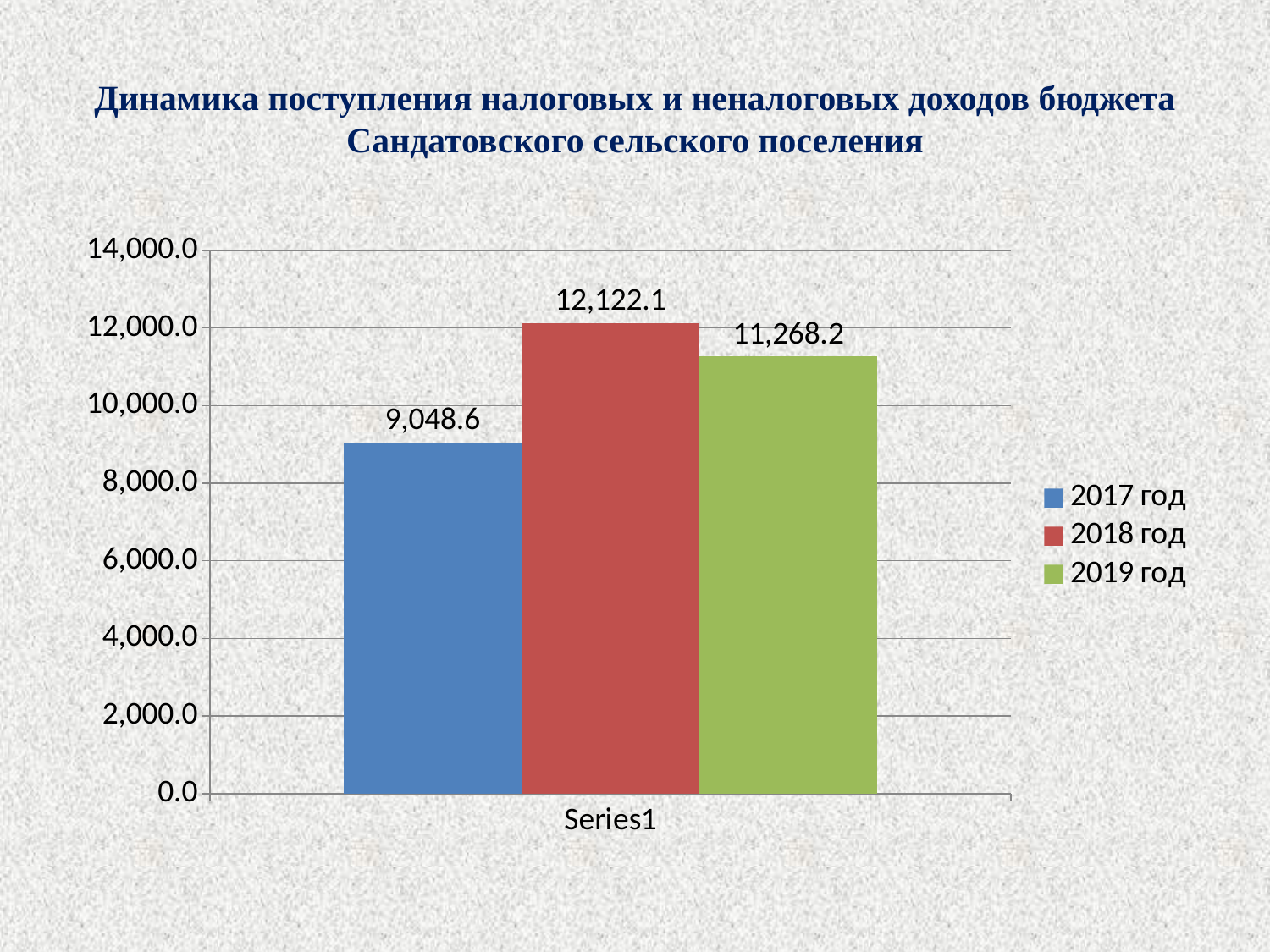
What is the difference between the values for 2018 год and 2017 год? 3,073.5 Is the value for 2017 год greater or less than 10,000.0? less Which year has the lowest value? 2017 год What is the difference between the values for 2018 год and 2019 год? 853.9 Which year has the highest value? 2018 год What is the value for 2017 год? 9,048.6 What is the value for 2019 год? 11,268.2 What kind of chart is shown on the slide? bar chart Which is larger, the value for 2019 год or the value for 2017 год? 2019 год What is the value for 2018 год? 12,122.1 What colour is the bar for 2018 год? red How many series does the legend list? 3